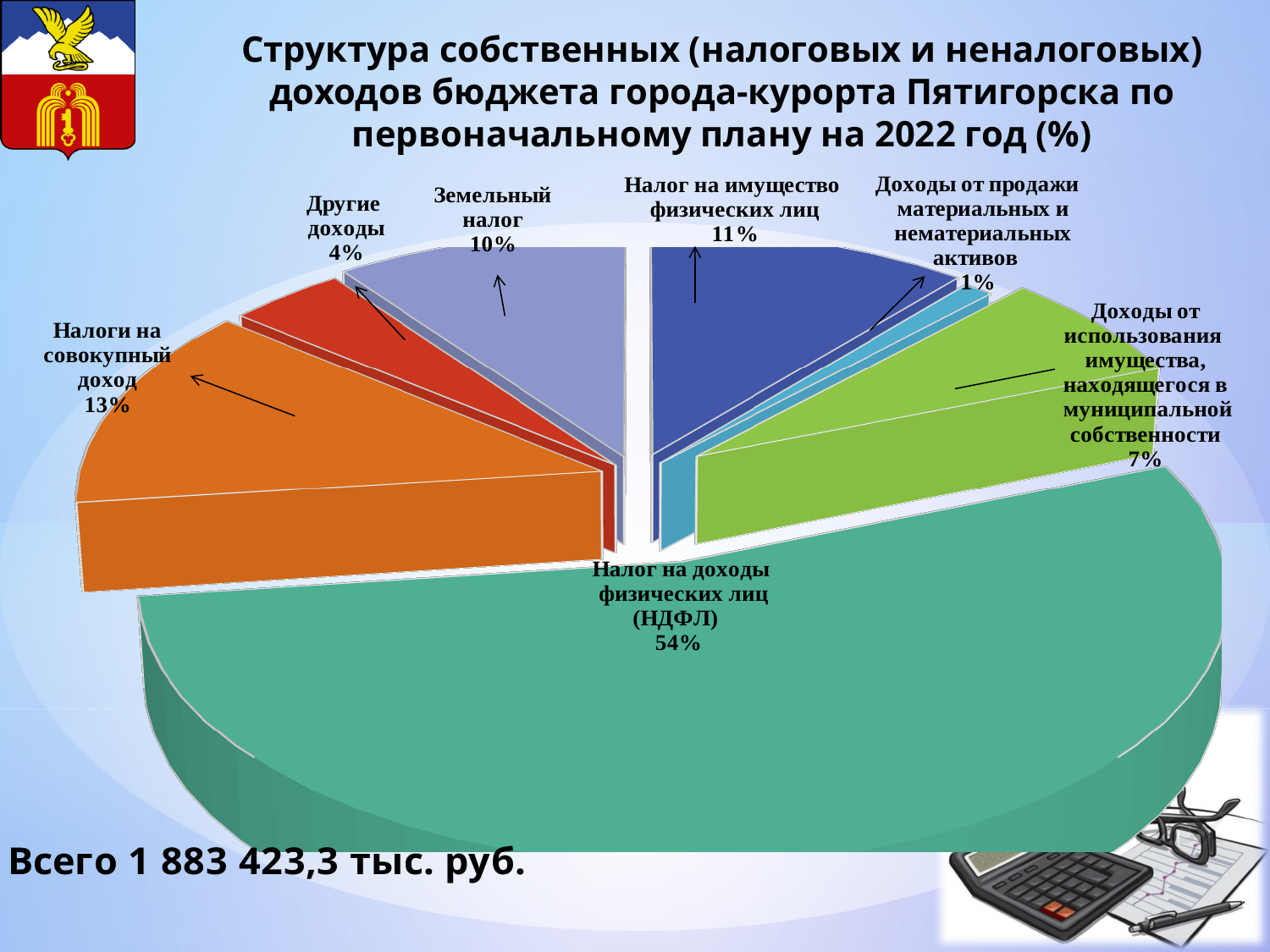
Which category has the smallest share of the pie? Доходы от продажи материальных и нематериальных активов What total amount of own revenues is stated on the slide? 1 883 423,3 тыс. руб. What type of chart is shown on the slide? Pie chart Which category has the largest share of the pie? Налог на доходы физических лиц (НДФЛ) What percentage is shown for «Налог на имущество физических лиц»? 11% What share of the budget's own revenues does «Налог на доходы физических лиц (НДФЛ)» account for? 54% What percentage is shown for «Доходы от использования имущества, находящегося в муниципальной собственности»? 7% What is the difference in percentage points between «Налоги на совокупный доход» and «Другие доходы»? 9 Which is larger: the share of «Налог на имущество физических лиц» or the share of «Земельный налог»? Налог на имущество физических лиц How many categories (slices) does the pie chart have? 7 What percentage is shown for «Налоги на совокупный доход»? 13% What percentage is shown for «Земельный налог»? 10%